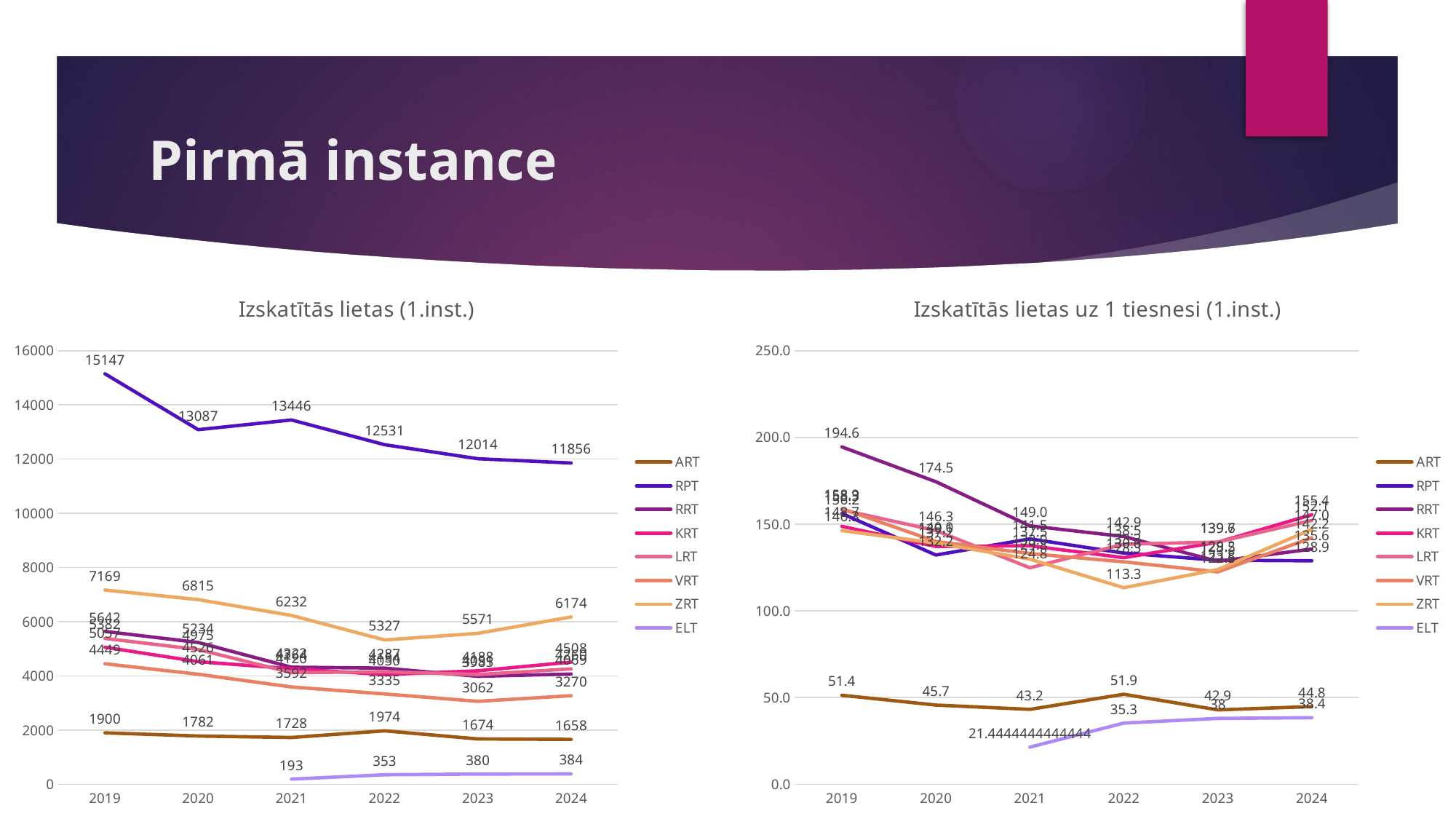
In "Izskatītās lietas (1.inst.)", what is the value for ELT in 2021? 193 How many series does the legend of "Izskatītās lietas (1.inst.)" list? 8 In "Izskatītās lietas (1.inst.)", what is the difference between the RPT values for 2019 and 2024? 3291 In "Izskatītās lietas (1.inst.)", what is the value for ZRT in 2019? 7169 In "Izskatītās lietas uz 1 tiesnesi (1.inst.)", what is the value for RRT in 2019? 194.6 In "Izskatītās lietas uz 1 tiesnesi (1.inst.)", how many years are shown on the x axis? 6 What kind of chart is "Izskatītās lietas (1.inst.)"? line chart In "Izskatītās lietas (1.inst.)", does the RPT line rise or fall from 2019 to 2024? fall In "Izskatītās lietas (1.inst.)", which series has the highest value in 2019? RPT In "Izskatītās lietas (1.inst.)", what is the value for RPT in 2019? 15147 In "Izskatītās lietas uz 1 tiesnesi (1.inst.)", what is the value for ART in 2022? 51.9 In "Izskatītās lietas uz 1 tiesnesi (1.inst.)", is the value for RRT in 2019 greater or less than 200.0? less